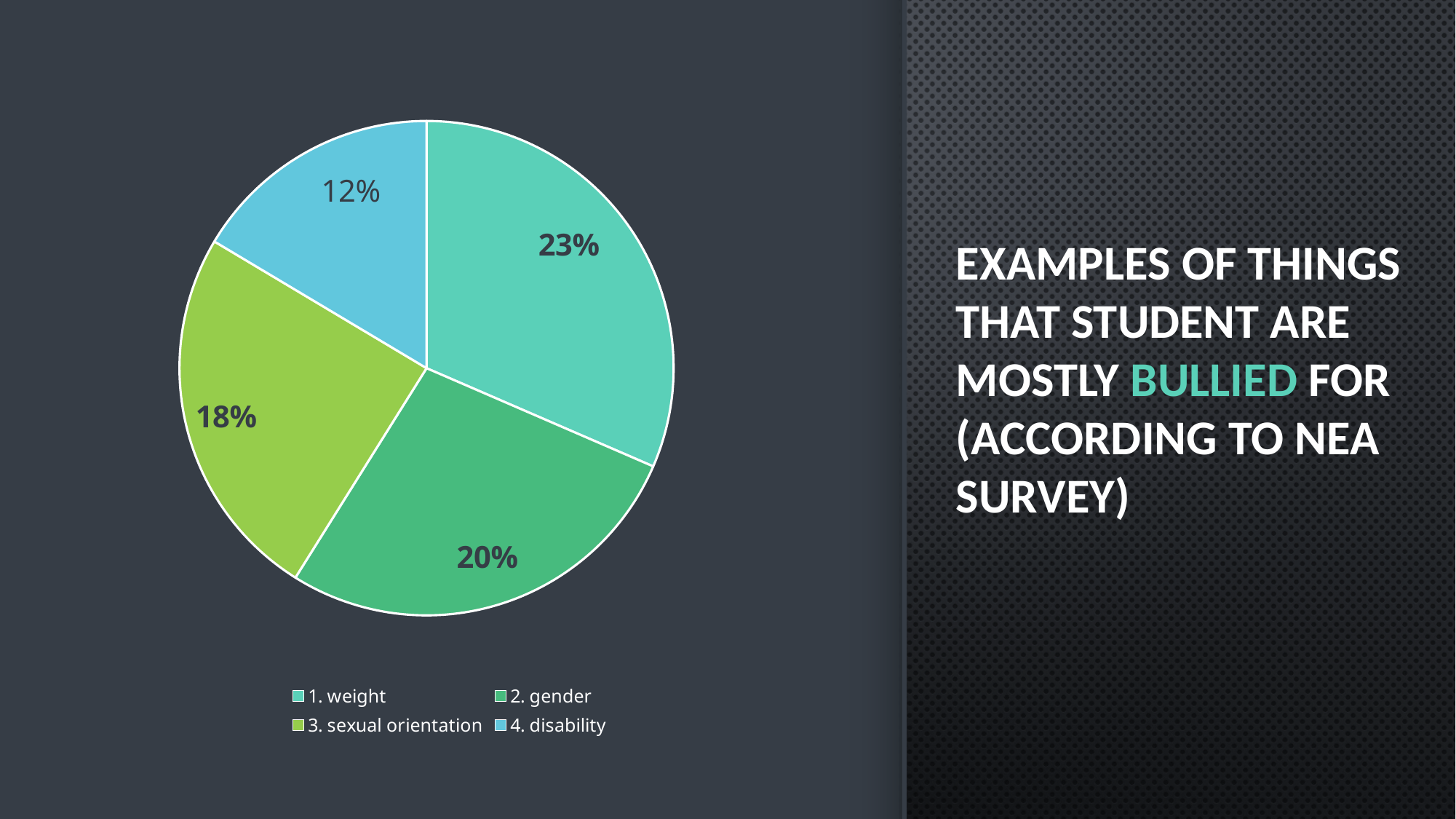
What type of chart is shown on the slide? pie chart What percentage is shown for 2. gender? 20% Which category has the smallest slice of the pie? 4. disability Which is larger, the slice for 2. gender or the slice for 3. sexual orientation? 2. gender What percentage is shown for 1. weight? 23% What colour is the slice for 4. disability? light blue Which category has the largest slice of the pie? 1. weight What is the difference in percentage points between 1. weight and 4. disability? 11 What percentage is shown for 4. disability? 12% What is the difference in percentage points between 2. gender and 3. sexual orientation? 2 How many categories does the pie chart show? 4 What percentage is shown for 3. sexual orientation? 18%